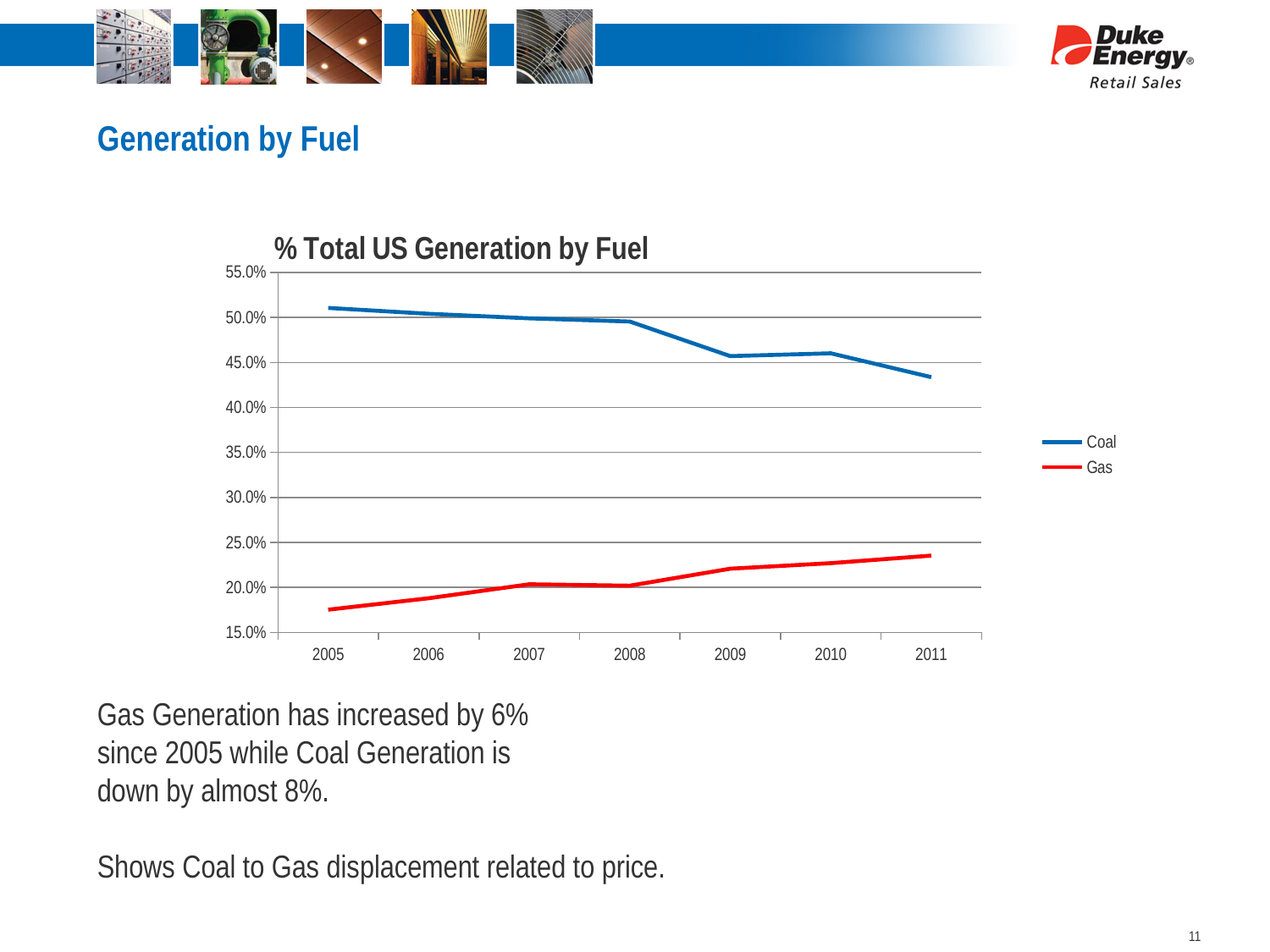
Is the value for Coal in 2005 greater or less than 50.0%? greater In which year is the Gas value lowest? 2005 Is the value for Gas in 2005 greater or less than 20.0%? less Which series is drawn in red? Gas In 2011, which is larger, the Coal value or the Gas value? Coal How many series does the legend list? 2 How many years are shown on the x axis? 7 Does the Gas line rise or fall from 2005 to 2011? Rise What is the title of the chart? % Total US Generation by Fuel What kind of chart is shown on the slide? Line chart Does the Coal line rise or fall from 2005 to 2011? Fall In which year is the Coal value highest? 2005